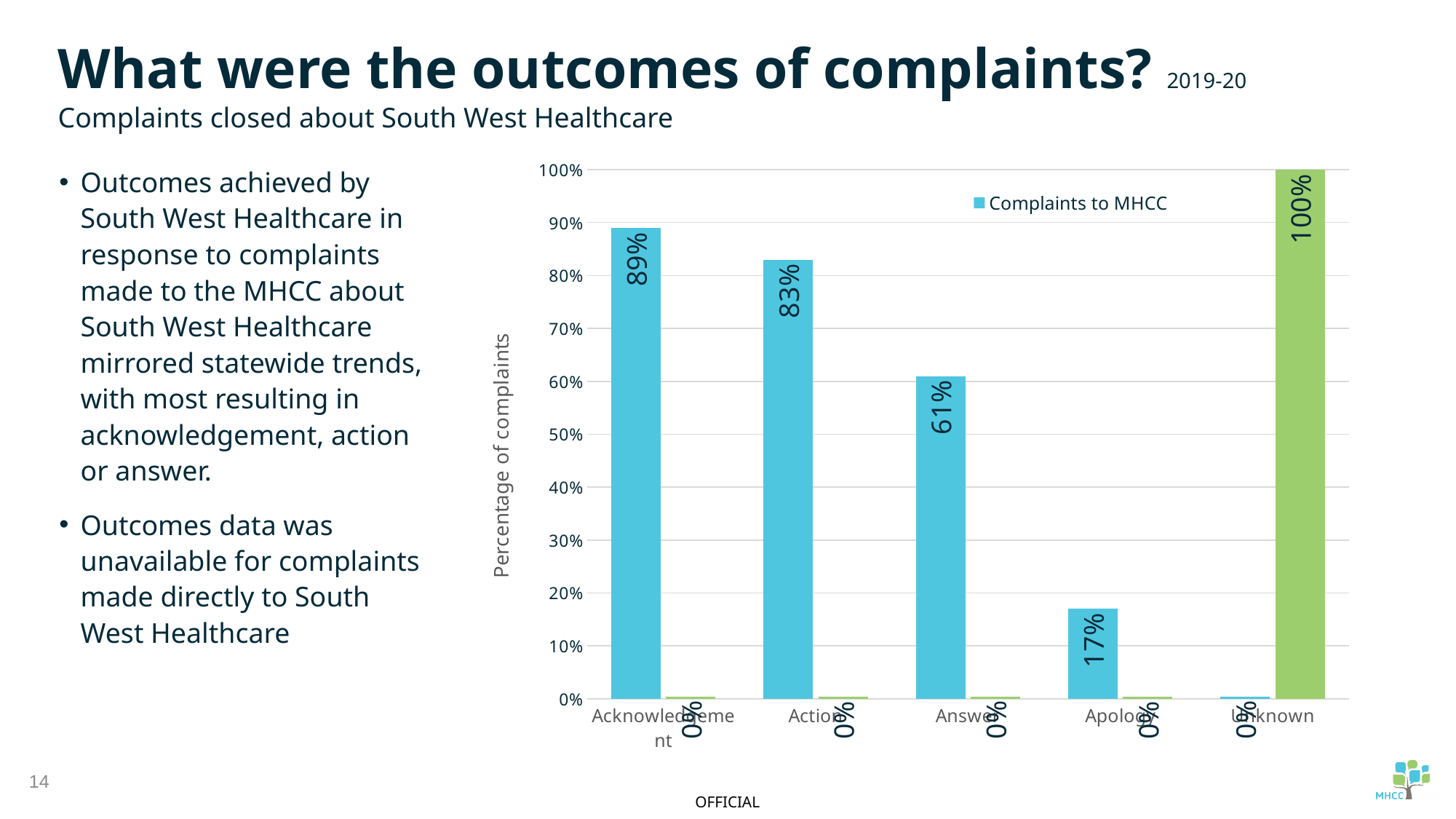
What is the Complaints to MHCC value for Action? 83% Which category has the lowest Complaints to MHCC value? Unknown What value does the green bar show for Unknown? 100% What kind of chart is shown on the slide? Bar chart What is the Complaints to MHCC value for Answer? 61% What is the Complaints to MHCC value for Apology? 17% How many series does the legend list? 1 What is the difference between the Complaints to MHCC values for Acknowledgement and Action? 6 percentage points Which category has the highest Complaints to MHCC value? Acknowledgement What is the Complaints to MHCC value for Acknowledgement? 89% Which has a larger Complaints to MHCC value, Answer or Apology? Answer How many categories are shown on the x axis? 5